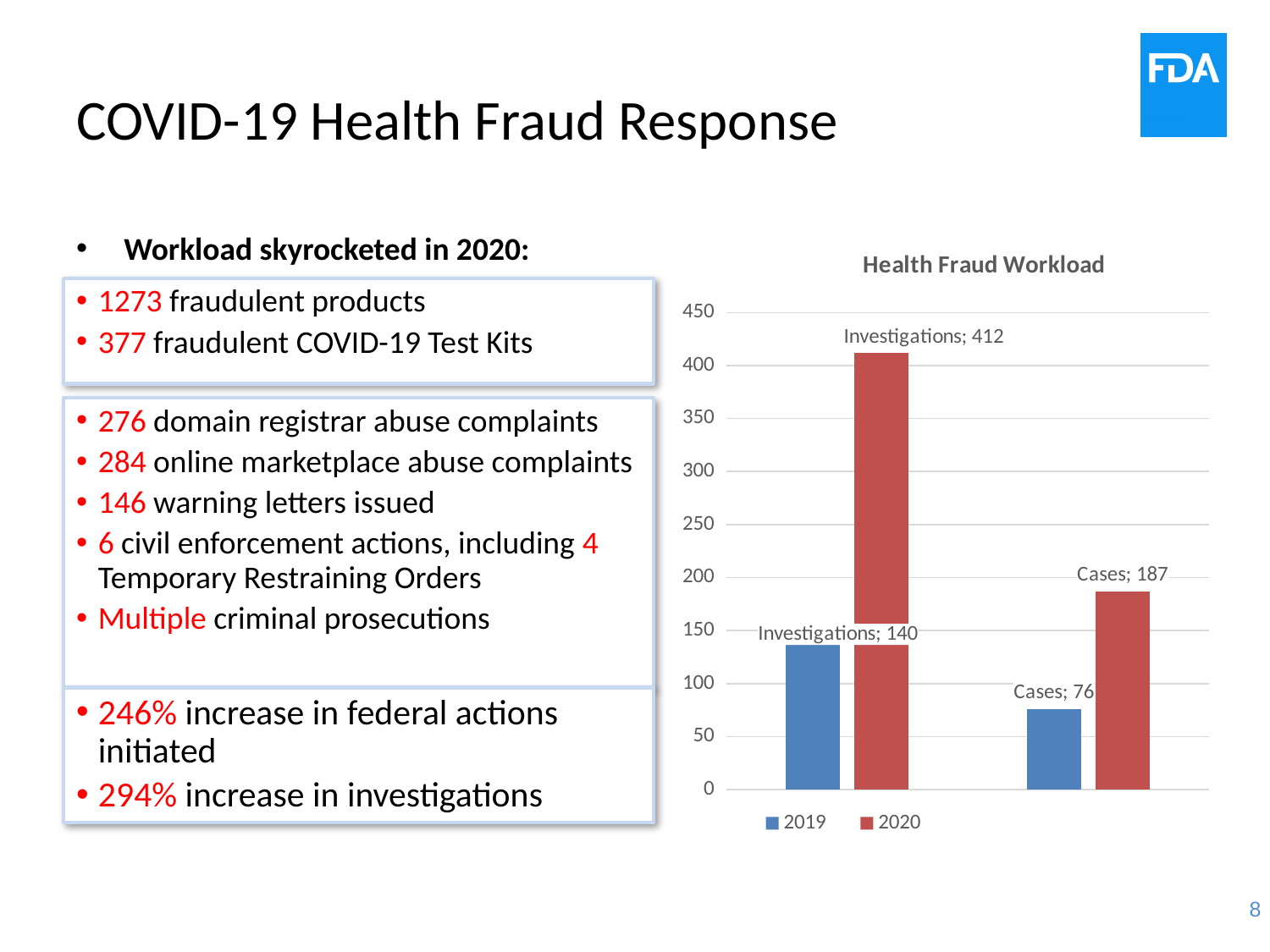
Which bar has the lowest value in the chart? Cases in 2019 What is the value for Cases in 2020? 187 What is the difference between Investigations in 2020 and Investigations in 2019? 272 How many series does the legend list? 2 What kind of chart is shown on the slide? Bar chart What is the value for Investigations in 2019? 140 What is the difference between Cases in 2020 and Cases in 2019? 111 What is the title of the chart? Health Fraud Workload Which is larger, Cases in 2020 or Investigations in 2019? Cases in 2020 Which bar has the highest value in the chart? Investigations in 2020 What is the value for Cases in 2019? 76 What is the value for Investigations in 2020? 412